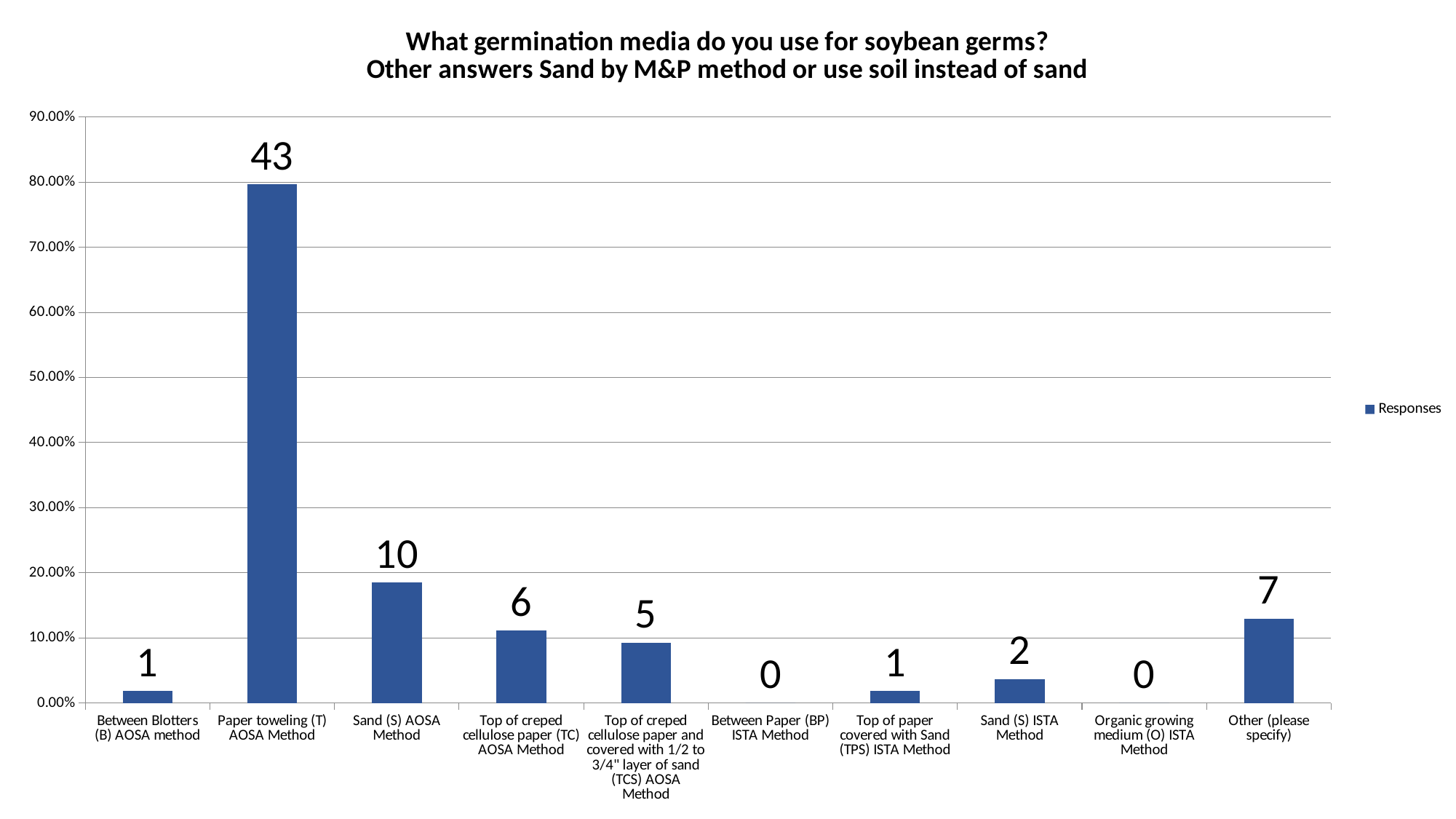
Which category has the highest bar? Paper toweling (T) AOSA Method How many series does the legend list? 1 What is the difference between the data labels for Sand (S) AOSA Method and Top of creped cellulose paper (TC) AOSA Method? 4 What data label is shown for Other (please specify)? 7 Is the value for Sand (S) AOSA Method greater or less than 20.00%? less How many categories are shown on the x axis? 10 What kind of chart is this? Bar chart Which is larger, the bar for Other (please specify) or the bar for Sand (S) ISTA Method? Other (please specify) Is the value for Paper toweling (T) AOSA Method greater or less than 70.00%? greater What data label is shown for Sand (S) ISTA Method? 2 What data label is shown for Paper toweling (T) AOSA Method? 43 What data label is shown for Sand (S) AOSA Method? 10